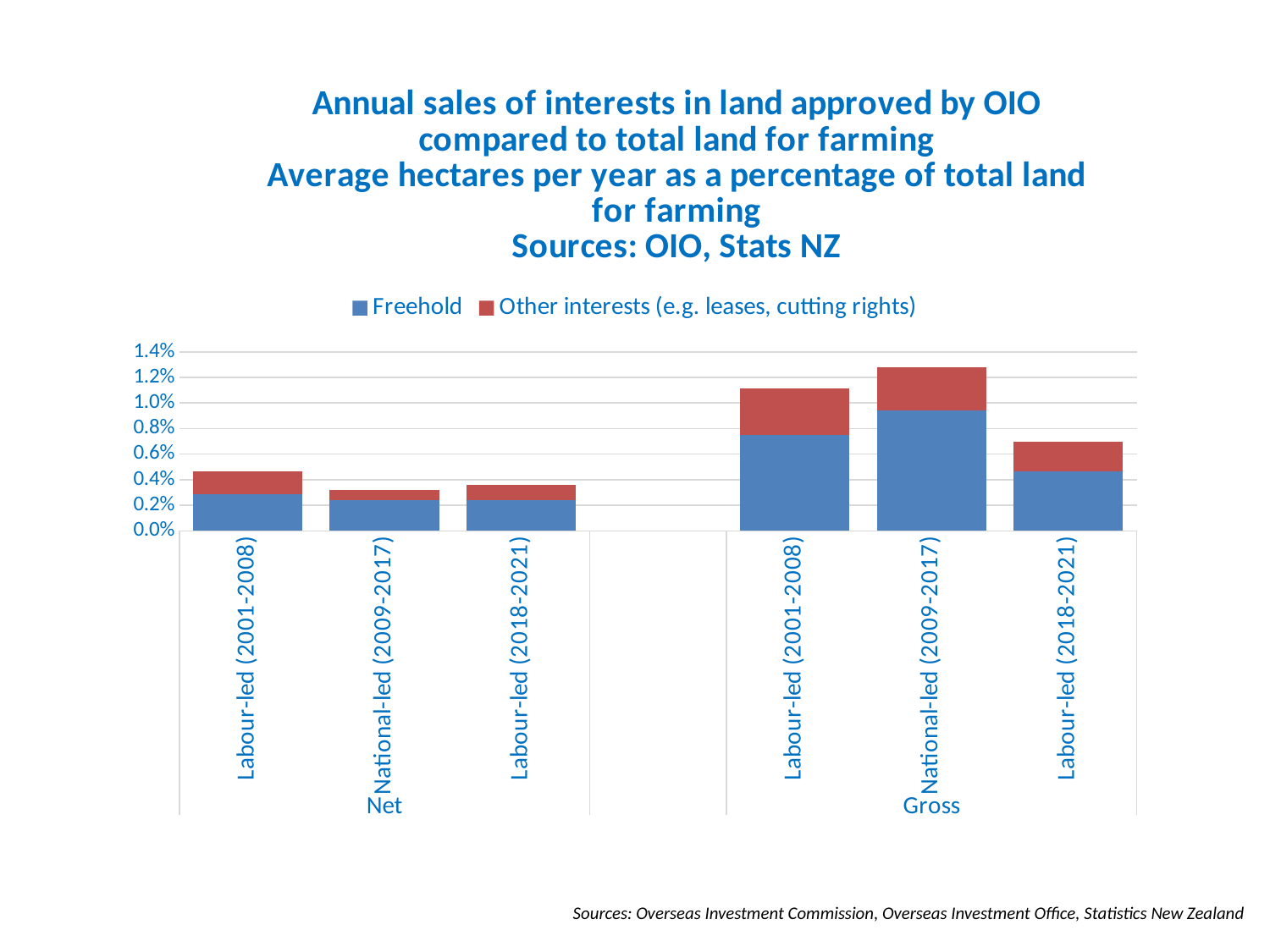
Is the total value for the Net Labour-led (2001-2008) bar greater or less than 0.6%? less Is the total value for the Gross Labour-led (2018-2021) bar greater or less than 0.8%? less Which bar has the highest total value in the chart? Gross National-led (2009-2017) What kind of chart is shown on the slide? Stacked bar chart How many series does the legend list? 2 Which series is shown in red in the chart? Other interests (e.g. leases, cutting rights) How many bars are plotted in the chart? 6 Which has the larger total value: the Gross Labour-led (2001-2008) bar or the Gross Labour-led (2018-2021) bar? Gross Labour-led (2001-2008) What are the two groups into which the bars are divided along the x axis? Net and Gross Is the total value for the Gross National-led (2009-2017) bar greater or less than 1.2%? greater